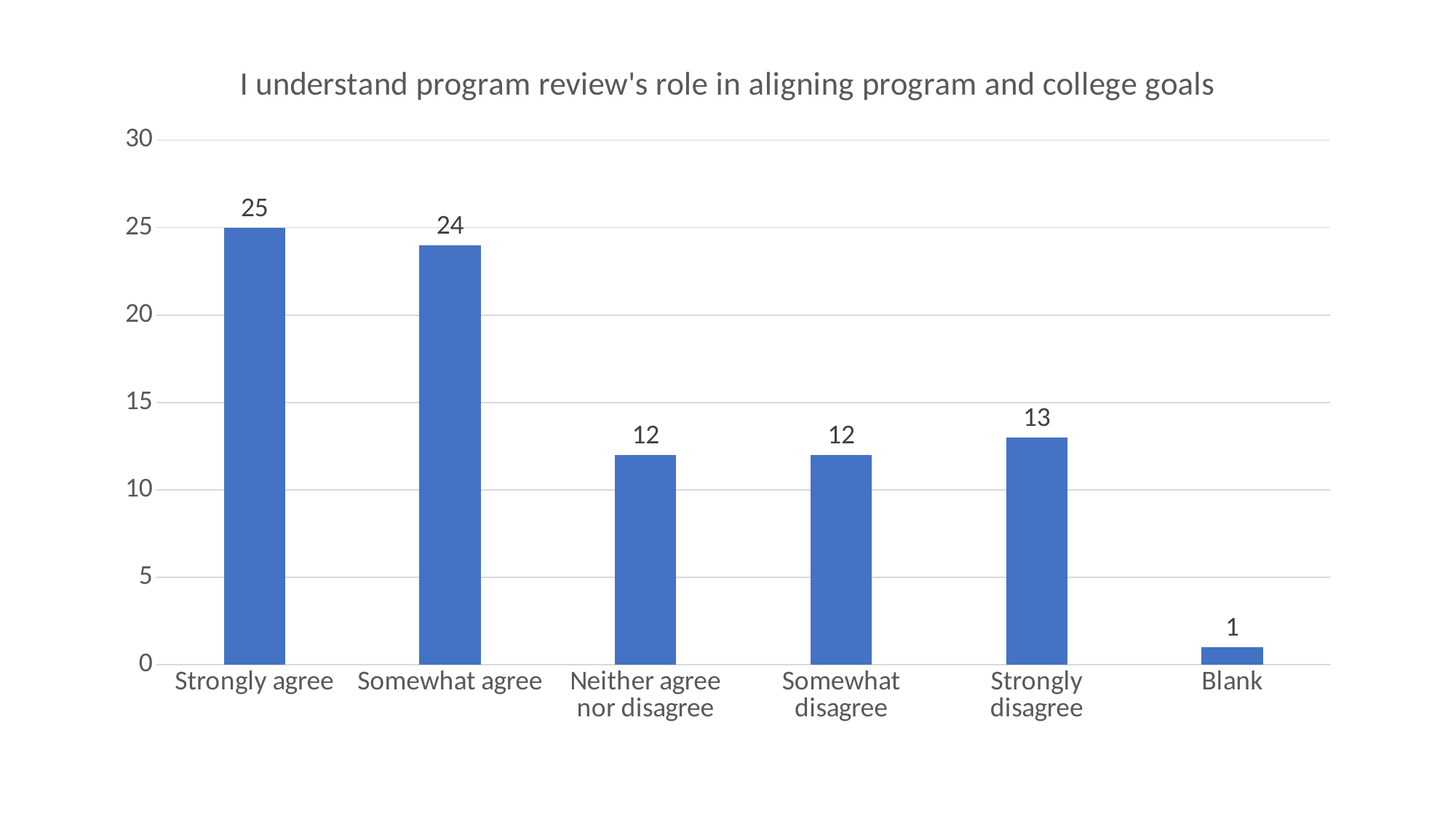
What kind of chart is this? bar chart How many categories are shown on the x axis? 6 What is the title of the chart? I understand program review's role in aligning program and college goals Which category has the highest value? Strongly agree Which is larger, the value for Somewhat agree or the value for Neither agree nor disagree? Somewhat agree What is the value for Somewhat agree? 24 Is the value for Somewhat disagree greater or less than 15? less What is the value for Blank? 1 What is the difference between the values for Strongly agree and Strongly disagree? 12 What is the value for Strongly disagree? 13 What is the value for Strongly agree? 25 Which category has the lowest value? Blank